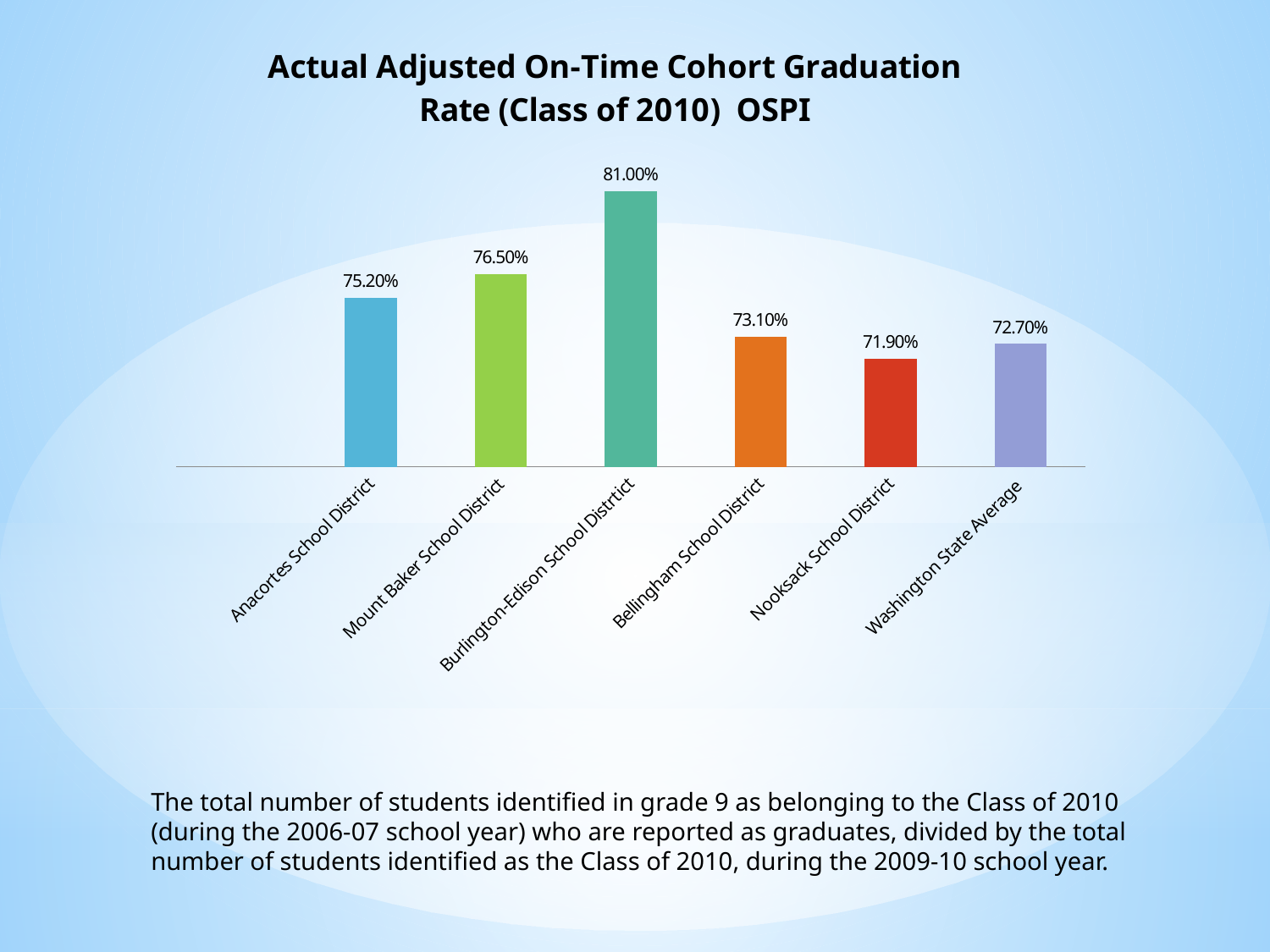
What is the graduation rate for Anacortes School District? 75.20% What is the graduation rate for Nooksack School District? 71.90% What is the title of the chart? Actual Adjusted On-Time Cohort Graduation Rate (Class of 2010) OSPI What is the difference between the graduation rates of Burlington-Edison School District and Mount Baker School District? 4.50% How many categories are shown on the chart? 6 What is the difference between Bellingham School District's rate and the Washington State Average? 0.40% What is the graduation rate for Burlington-Edison School District? 81.00% What is the value shown for Washington State Average? 72.70% Which category has the lowest value on the chart? Nooksack School District Which is larger, the graduation rate for Mount Baker School District or for Bellingham School District? Mount Baker School District What kind of chart is shown on the slide? Bar chart Which district has the highest graduation rate? Burlington-Edison School District